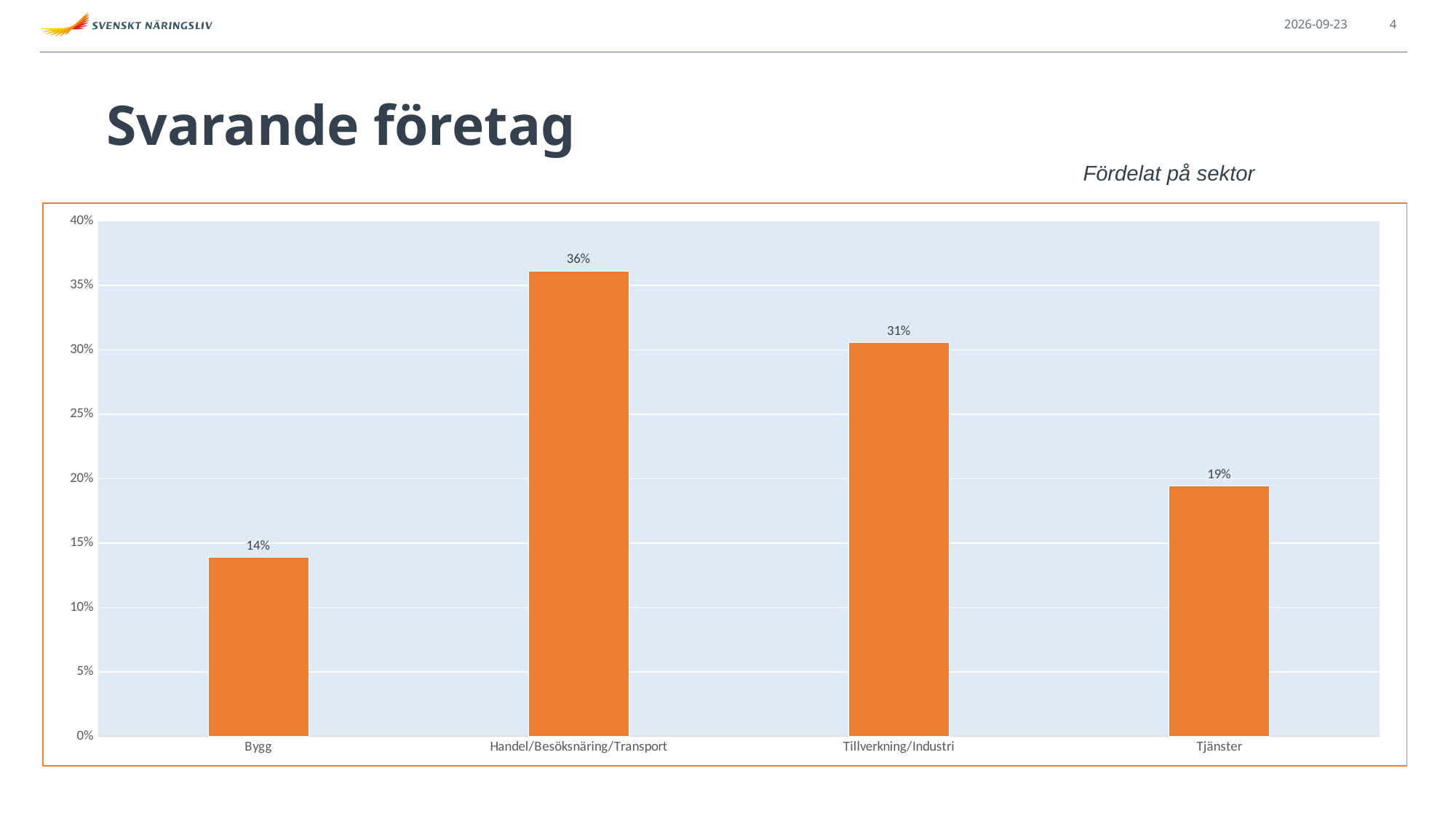
Is the value for Tillverkning/Industri greater or less than 30%? greater What is the value for Tjänster? 19% What is the value for Bygg? 14% What is the value for Tillverkning/Industri? 31% Which sector has the lowest value? Bygg What kind of chart is shown on the slide? Bar chart What is the value for Handel/Besöksnäring/Transport? 36% What is the subtitle shown above the chart? Fördelat på sektor Which sector has the highest value? Handel/Besöksnäring/Transport What is the difference between the values for Handel/Besöksnäring/Transport and Tillverkning/Industri? 5 percentage points How many sectors are shown on the chart? 4 Which is larger, the value for Tjänster or the value for Bygg? Tjänster